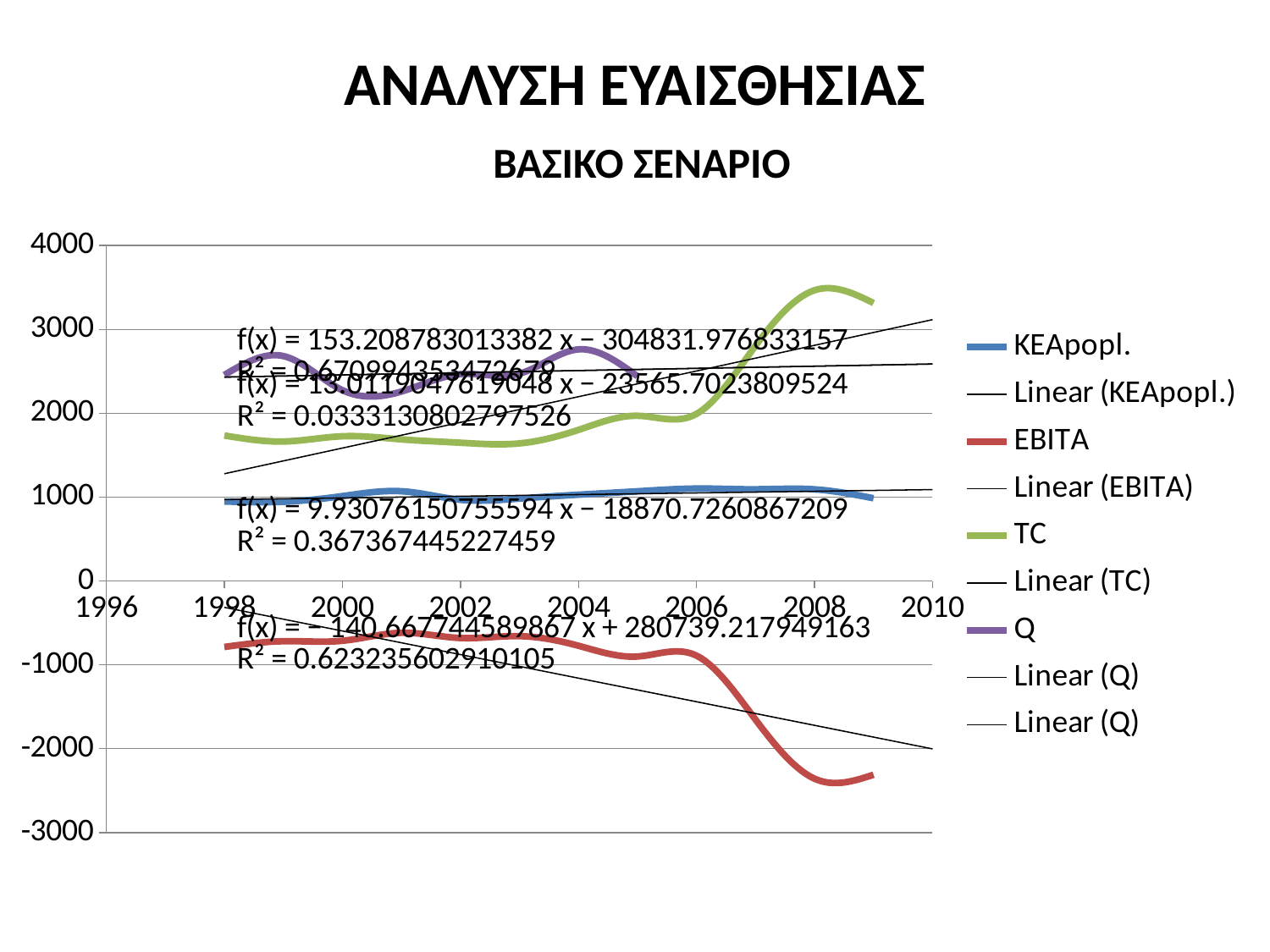
What is the title of the chart? ΒΑΣΙΚΟ ΣΕΝΑΡΙΟ Is the value of EBITA in 2008 greater or less than -2000? less Does the TC series rise or fall overall from 1998 to 2009? rise Which is larger in 2000, Q or KEApopl.? Q Does the EBITA series rise or fall overall from 1998 to 2009? fall Which series has the lowest value in 2008? EBITA How many entries does the chart legend list? 9 Which series has the highest value in 2008? TC Is the value of TC in 1998 greater or less than 1000? greater What kind of chart is shown on the slide? line chart Is the value of TC in 2008 greater or less than 3000? greater